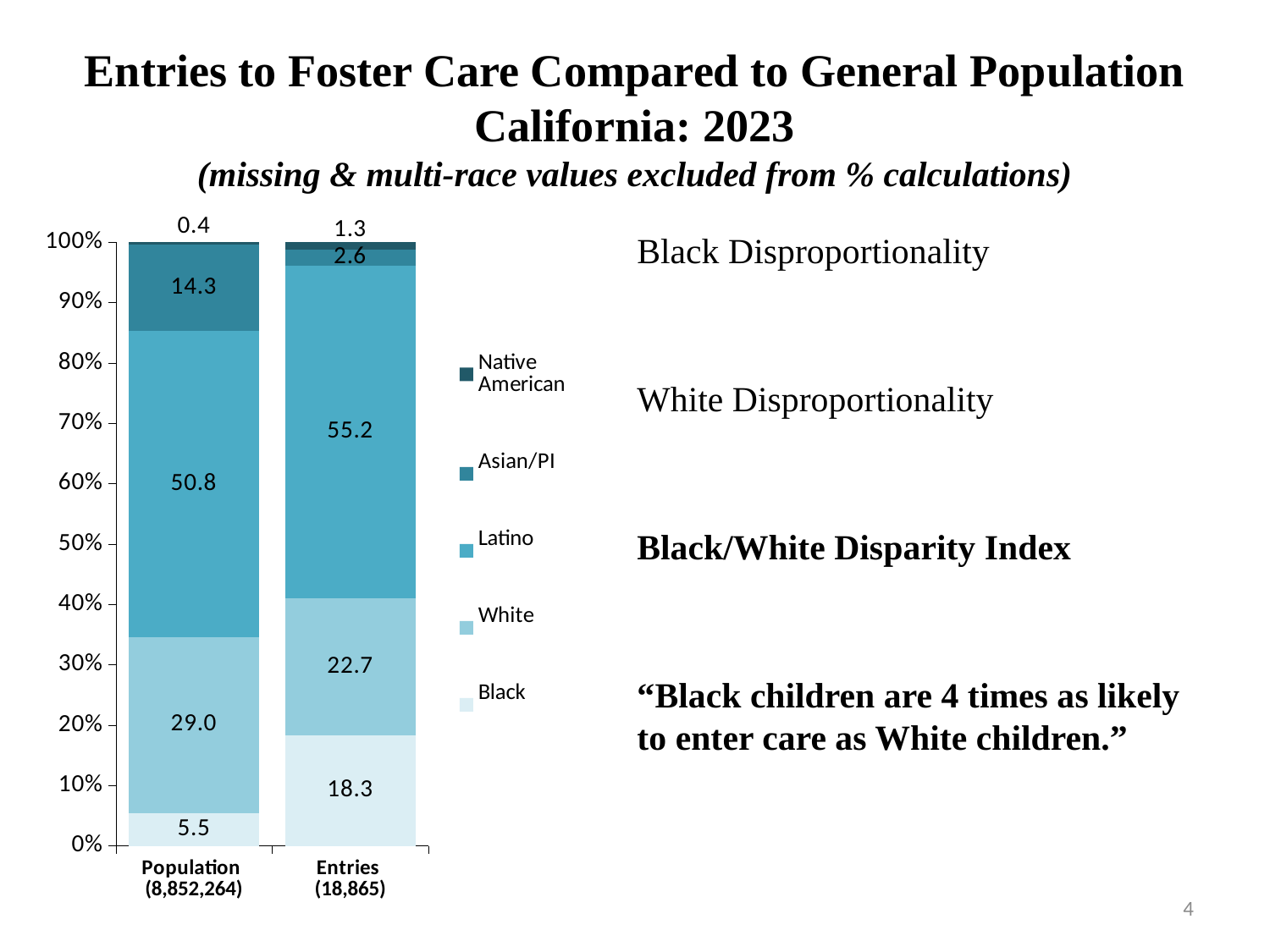
What is the Native American value for Entries? 1.3 What is the Black share of the Population bar? 5.5 How many series does the legend list? 5 What is the Asian/PI value for Population? 14.3 Is the White share larger for Population or for Entries? Population What is the difference between the Black share for Entries and the Black share for Population? 12.8 How many bars does the chart show? 2 Which group has the largest share in the Population bar? Latino What is the Latino value for Entries? 55.2 What is the Black share of the Entries bar? 18.3 Which group has the smallest share in the Entries bar? Native American What kind of chart is shown on the slide? Stacked bar chart